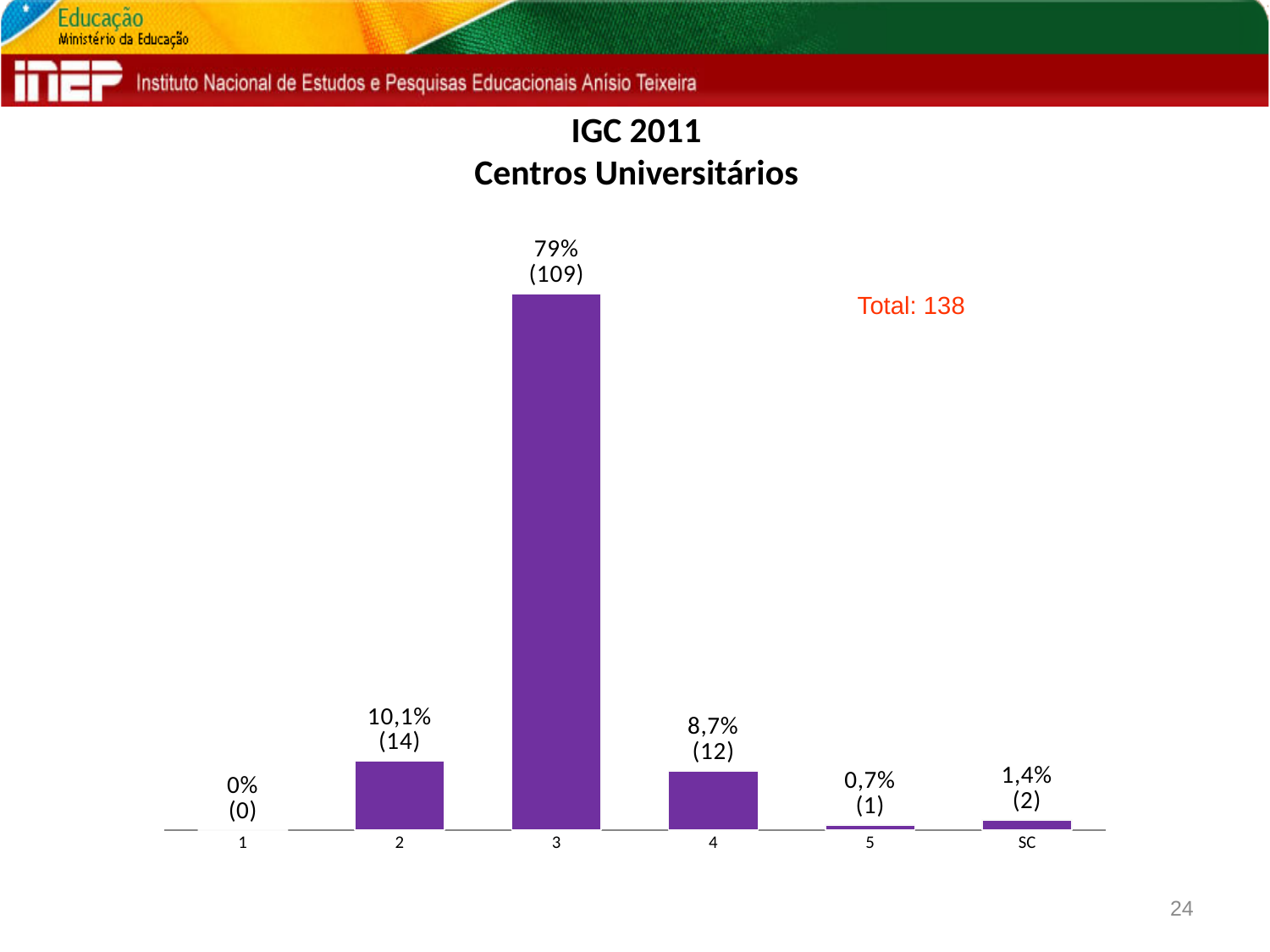
What kind of chart is this? bar chart What is the title of the chart? IGC 2011 Centros Universitários What percentage is shown for category 4? 8,7% How many institutions are in category 2? 14 What is the difference in count between category 3 and category 2? 95 What total is stated on the slide? 138 Which is larger, the value for category 2 or category 4? 2 How many categories are shown on the x axis? 6 Which category has the highest value? 3 Which category has the lowest value? 1 What count is shown for category SC? 2 What percentage is shown for category 3? 79%